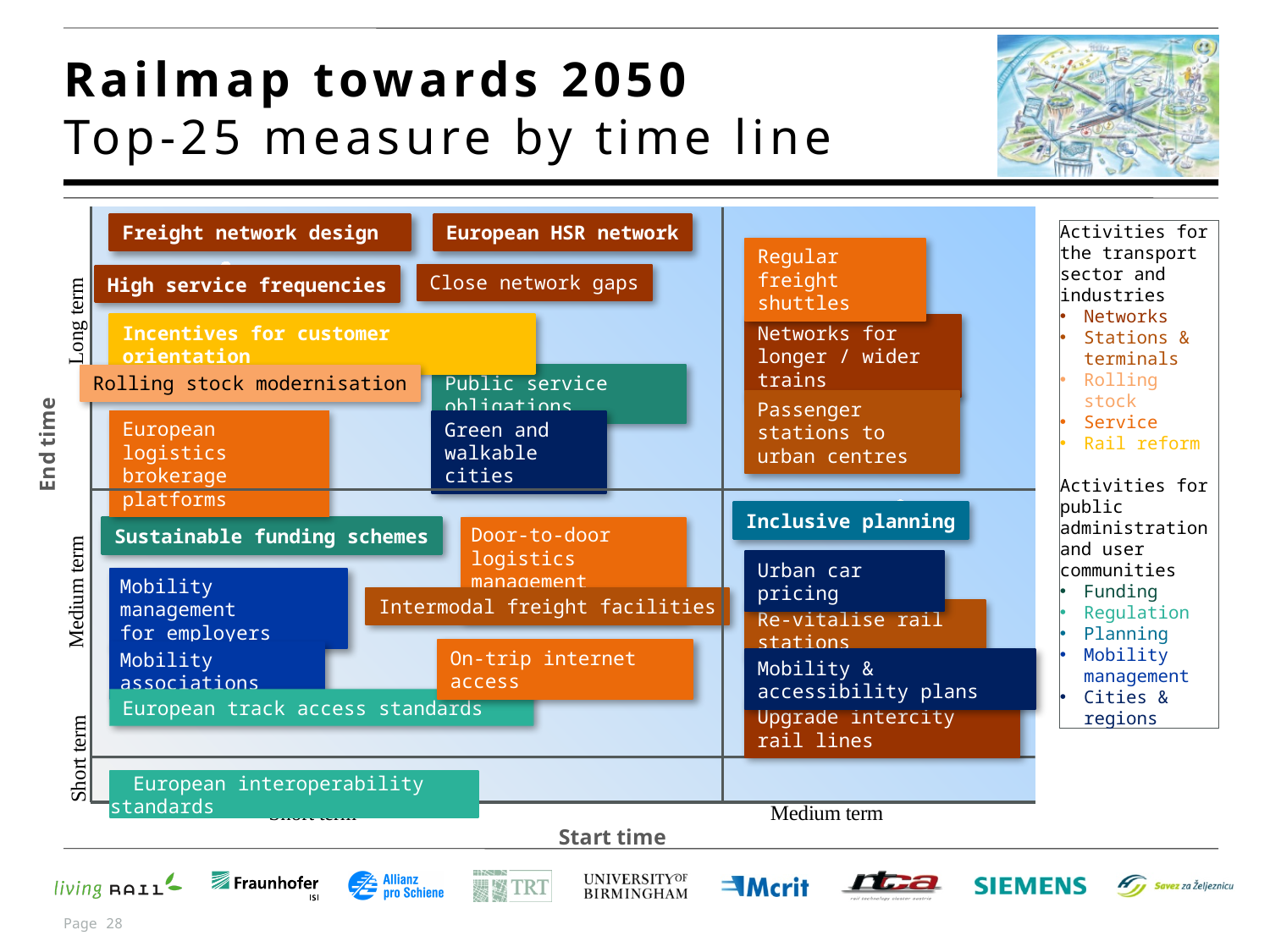
How many activity categories does the legend on the right of the chart list in total? 10 How many measures are shown in the Railmap towards 2050 chart? 25 What is the label of the vertical axis of the chart? End time Which measure is placed at the top of the medium-term start time column, in the medium-term end time band? Inclusive planning What is the label of the horizontal axis of the chart? Start time Which measure is placed in the short-term start time and short-term end time area of the chart? European interoperability standards Which measure appears at the top left of the chart, in the long-term end time band with a short-term start time? Freight network design